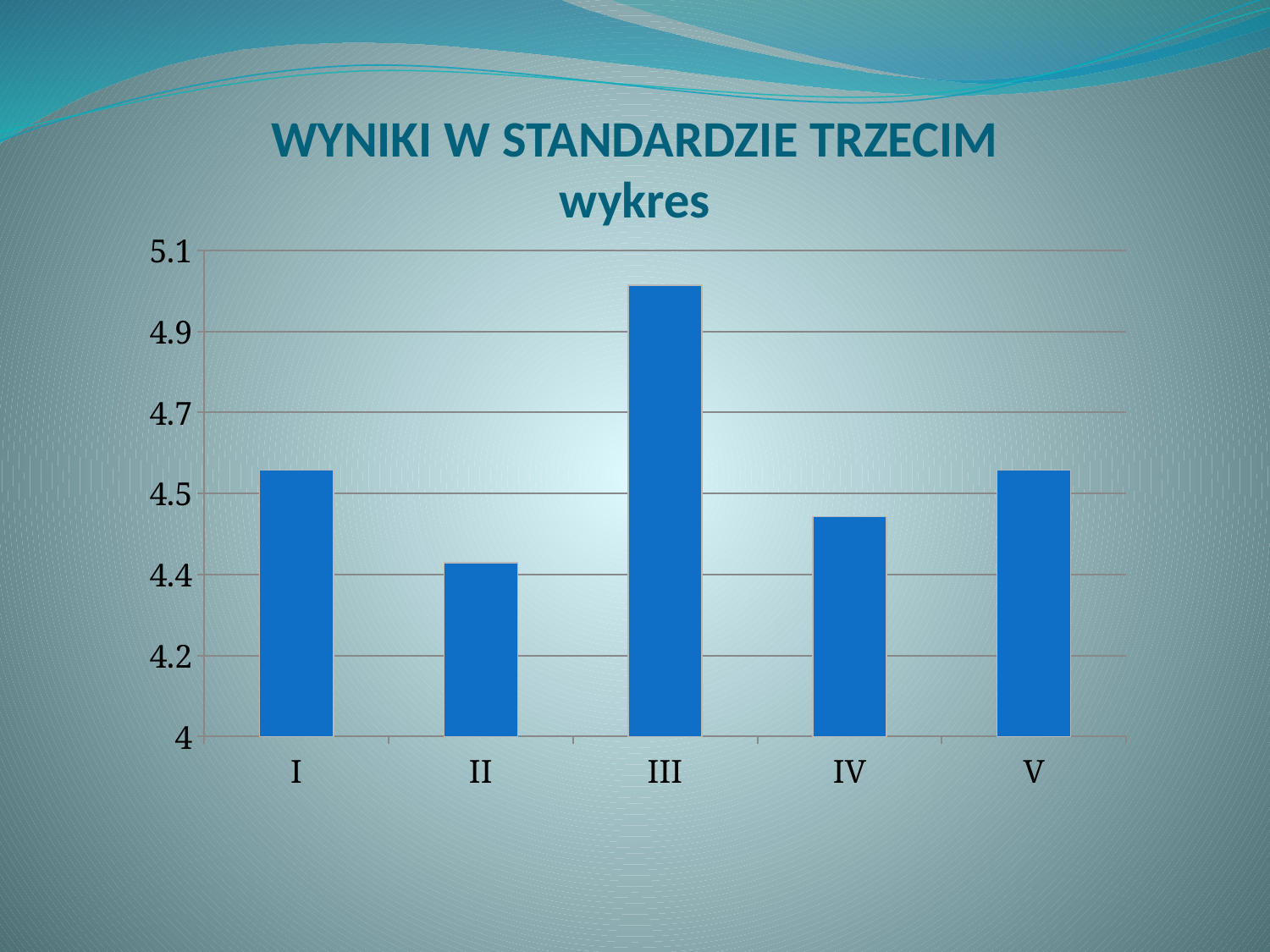
Is the value for IV greater or less than 4.4? greater Which is larger, the value for I or the value for II? I Is the value for V greater or less than 4.7? less What is the title of the chart? WYNIKI W STANDARDZIE TRZECIM wykres How many categories are shown on the x axis of the chart? 5 Which is larger, the value for III or the value for IV? III Which category has the highest value in the chart? III Is the value for I greater or less than 4.5? greater Which category has the lowest value in the chart? II What kind of chart is shown on the slide? bar chart